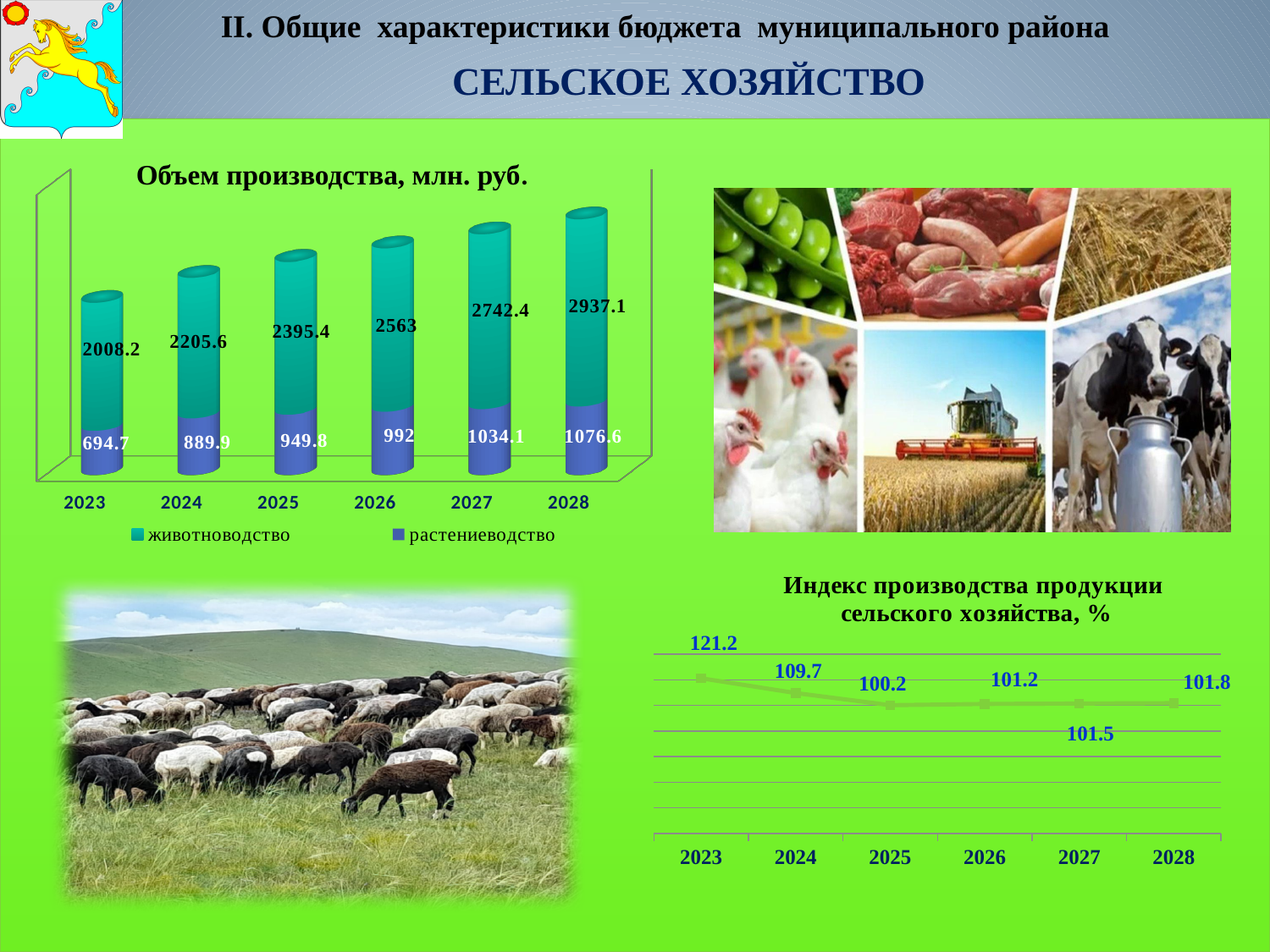
What kind of chart is 'Объем производства, млн. руб.'? Stacked bar chart In the chart 'Индекс производства продукции сельского хозяйства, %', how many years are plotted? 6 In the chart 'Индекс производства продукции сельского хозяйства, %', what is the value for 2024? 109.7 In the chart 'Объем производства, млн. руб.', what is the total of the stacked bar for 2028? 4013.7 In the chart 'Объем производства, млн. руб.', which year has the lowest value for растениеводство? 2023 In the chart 'Объем производства, млн. руб.', how many series does the legend list? 2 In the chart 'Индекс производства продукции сельского хозяйства, %', which year has the lowest value? 2025 In the chart 'Объем производства, млн. руб.', which year has the highest value for животноводство? 2028 In the chart 'Объем производства, млн. руб.', what is the value for растениеводство in 2026? 992 In the chart 'Индекс производства продукции сельского хозяйства, %', is the value for 2023 larger or smaller than the value for 2028? larger In the chart 'Объем производства, млн. руб.', what is the difference between the животноводство values for 2028 and 2023? 928.9 In the chart 'Объем производства, млн. руб.', what is the value for животноводство in 2023? 2008.2